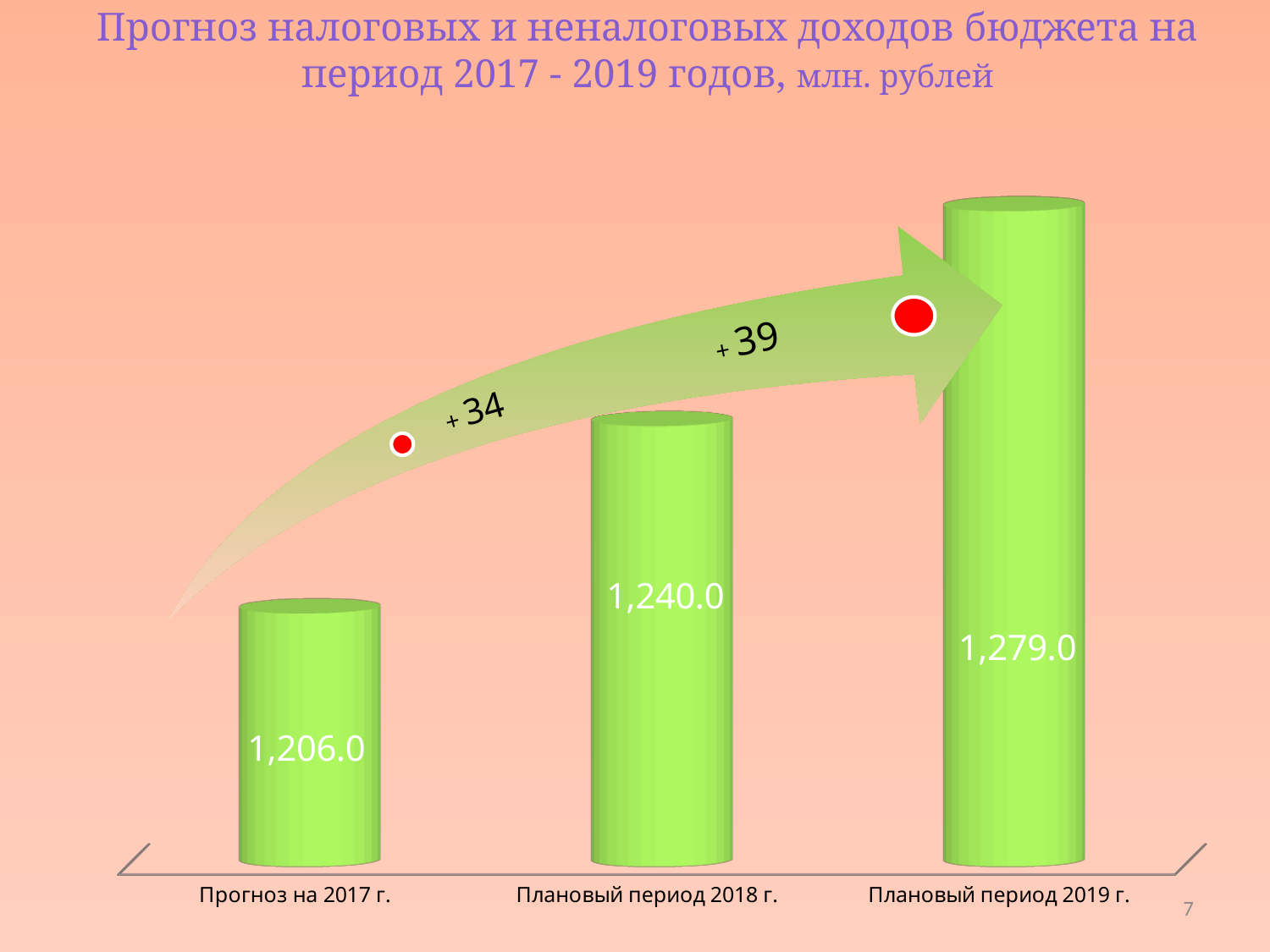
How many categories are shown on the chart? 3 What is the difference between the values for Плановый период 2019 г. and Плановый период 2018 г.? 39.0 Do the values rise or fall from 2017 to 2019? Rise Which category has the lowest value? Прогноз на 2017 г. What is the value for Прогноз на 2017 г.? 1,206.0 What is the value for Плановый период 2018 г.? 1,240.0 In what units are the values on the chart expressed, according to the title? млн. рублей What is the value for Плановый период 2019 г.? 1,279.0 What is the difference between the values for Плановый период 2018 г. and Прогноз на 2017 г.? 34.0 Which category has the highest value? Плановый период 2019 г. What kind of chart is shown on the slide? Bar chart Which is larger, the value for Прогноз на 2017 г. or the value for Плановый период 2019 г.? Плановый период 2019 г.